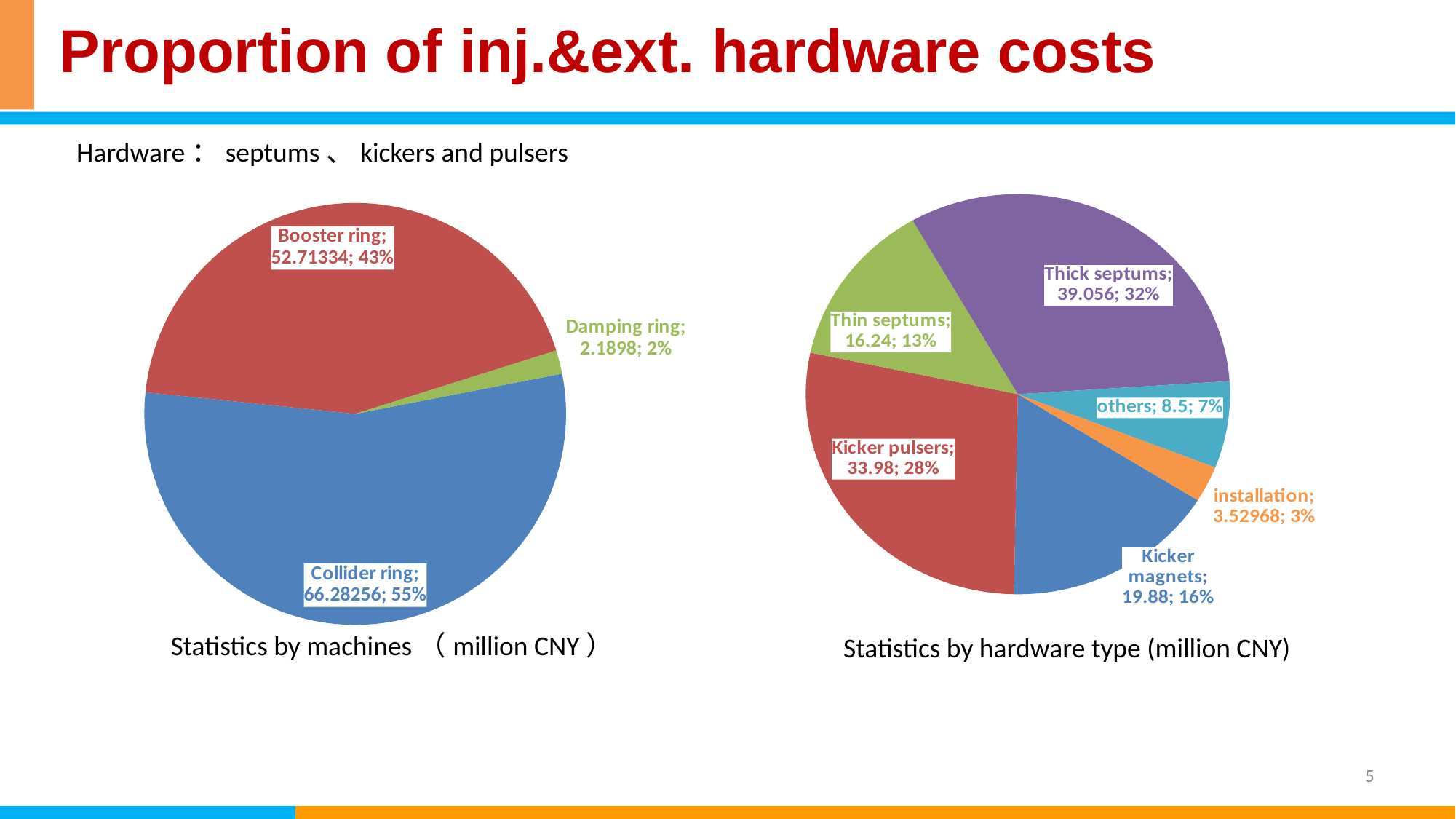
How many slices does the 'Statistics by machines' chart have? 3 In the 'Statistics by machines' chart, what is the value for the Booster ring? 52.71334 In the 'Statistics by hardware type' chart, what is the value for Kicker pulsers? 33.98 In the 'Statistics by hardware type' chart, which is larger: Thin septums or Kicker magnets? Kicker magnets In the 'Statistics by hardware type' chart, what share of the pie do Kicker magnets take? 16% In the 'Statistics by hardware type' chart, which hardware type has the largest cost? Thick septums What type of chart is the 'Statistics by hardware type' chart? Pie chart In the 'Statistics by machines' chart, which machine has the smallest cost? Damping ring In the 'Statistics by machines' chart, what is the difference between the Collider ring and Booster ring values? 13.56922 In the 'Statistics by hardware type' chart, what is the difference between the Thick septums and Kicker pulsers values? 5.076 In the 'Statistics by hardware type' chart, which hardware type has the smallest cost? installation In the 'Statistics by machines' chart, what share of the pie does the Collider ring take? 55%